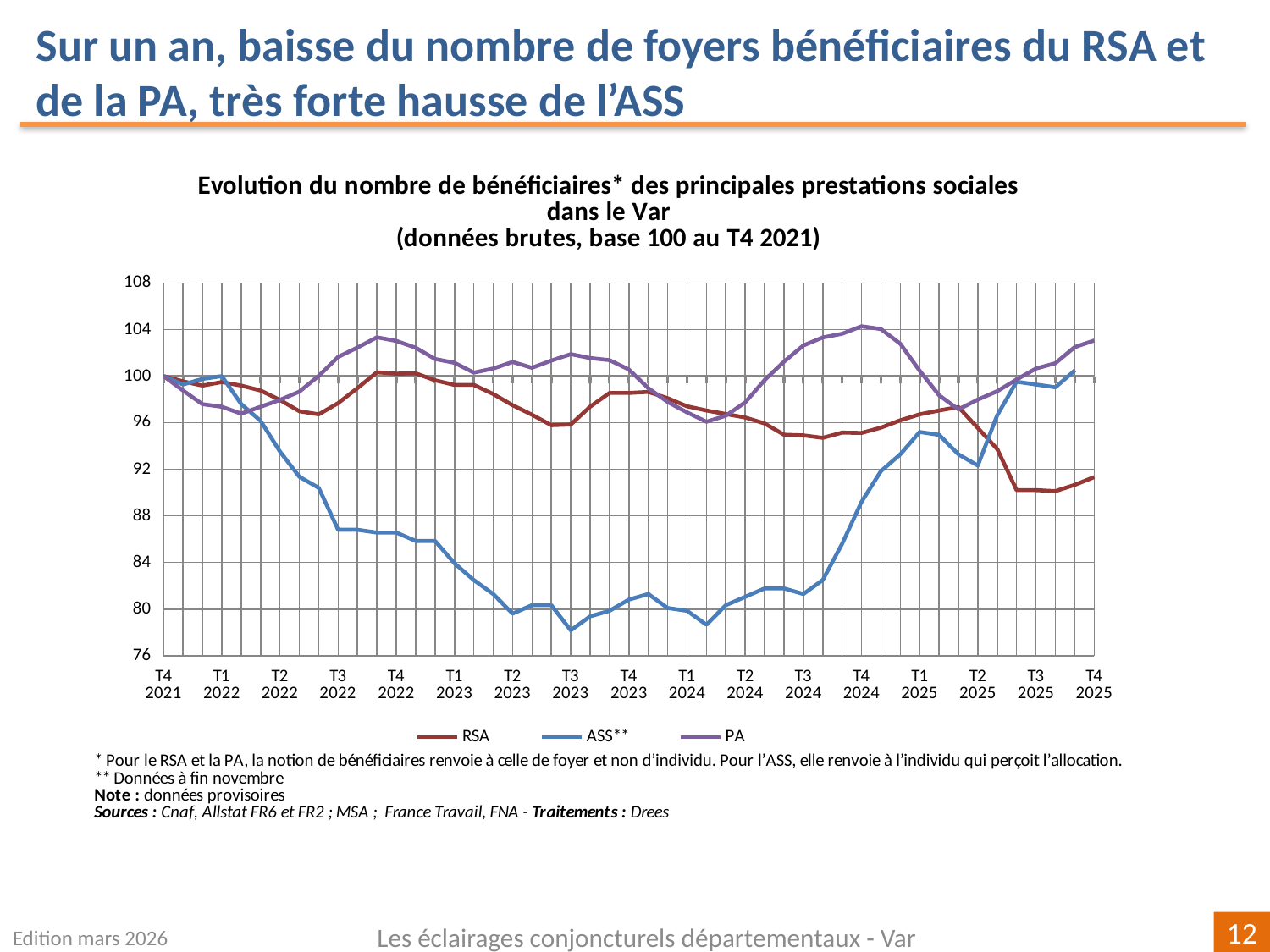
How many quarters are labelled on the x axis? 17 Which series has the highest value at T4 2024? PA Does the ASS** series rise or fall between T4 2021 and T3 2023? fall Is the value for PA at T4 2024 greater or less than 100? greater Which series are listed in the legend? RSA, ASS**, PA What kind of chart is shown on the slide? line chart Which series has the lowest value at T3 2023? ASS** Is the value for ASS** at T3 2023 greater or less than 80? less What is the value of the RSA series at T4 2021? 100 Is the value for ASS** at T3 2022 greater or less than 84? greater How many series does the legend list? 3